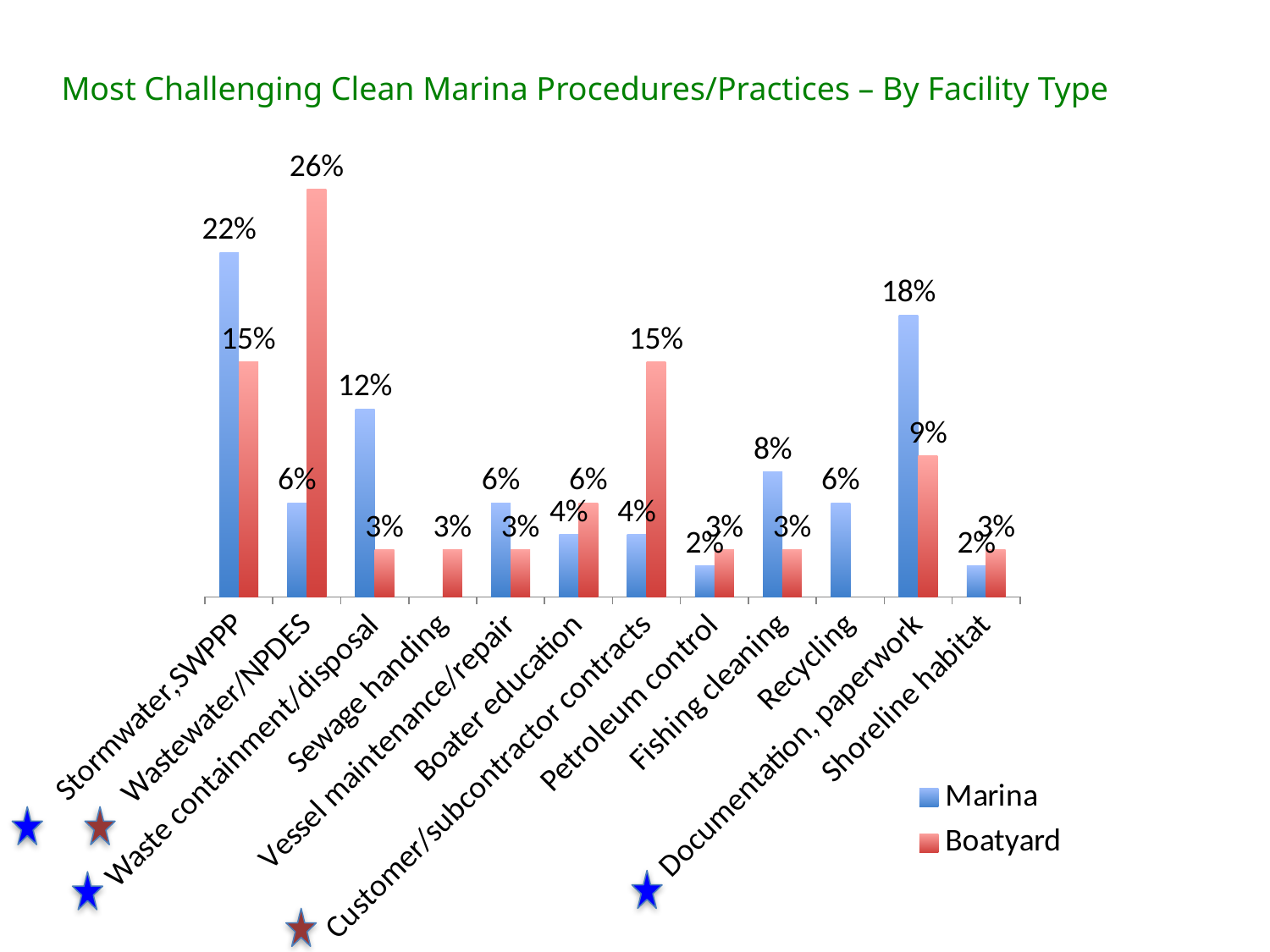
What is the difference between the Marina and Boatyard values for Stormwater,SWPPP? 7% How many series does the legend list? 2 What kind of chart is shown on the slide? Bar chart What is the Boatyard value for Customer/subcontractor contracts? 15% What is the Boatyard value for Wastewater/NPDES? 26% Which category has the highest Marina value? Stormwater,SWPPP What is the difference between the Boatyard and Marina values for Wastewater/NPDES? 20% What is the Marina value for Stormwater,SWPPP? 22% Which category has the highest Boatyard value? Wastewater/NPDES What is the Marina value for Documentation, paperwork? 18% How many categories are shown on the x axis? 12 Which is larger for Documentation, paperwork: the Marina value or the Boatyard value? Marina